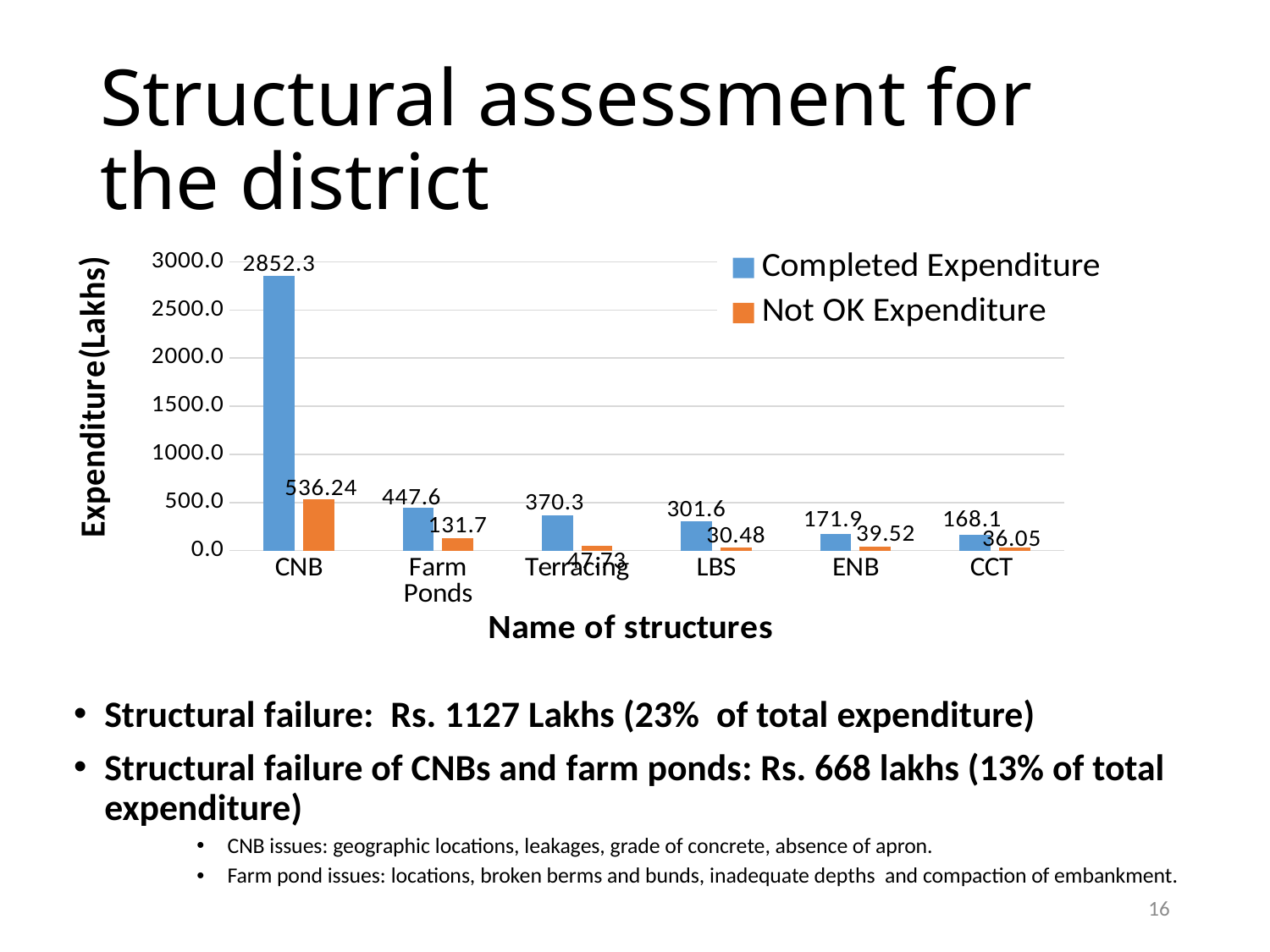
What is the Completed Expenditure for CNB? 2852.3 How many structure categories are shown on the x axis? 6 Is the Completed Expenditure for CNB greater or less than 2500.0? greater Which structure has the lowest Completed Expenditure? CCT Which structure has the highest Completed Expenditure? CNB What is the difference between the Completed Expenditure and the Not OK Expenditure for CNB? 2316.06 What is the Not OK Expenditure for ENB? 39.52 What is the Not OK Expenditure for Farm Ponds? 131.7 What kind of chart is shown on the slide? bar chart Which is larger, the Completed Expenditure for Farm Ponds or for Terracing? Farm Ponds What is the Completed Expenditure for LBS? 301.6 How many series does the legend list? 2